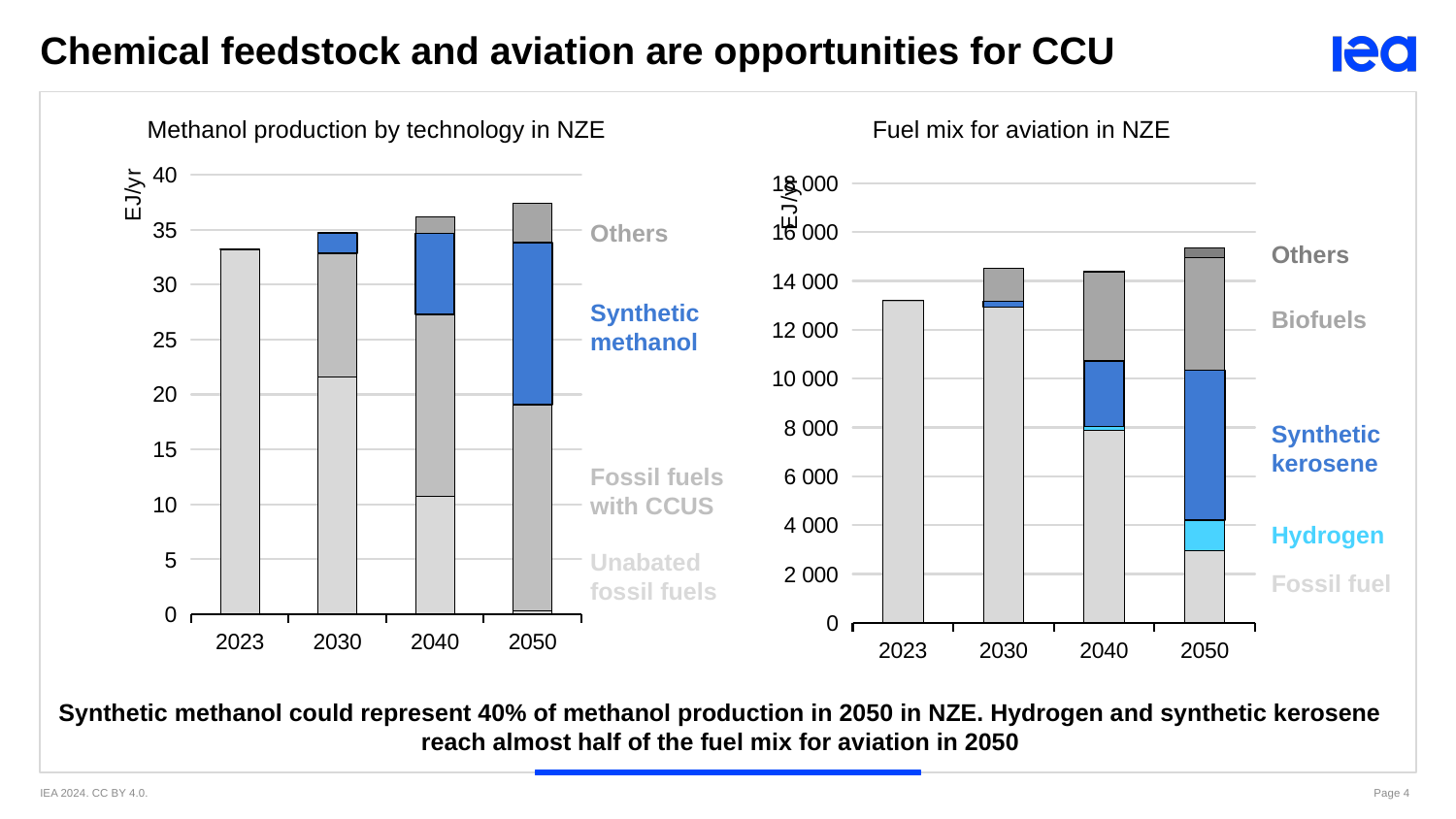
In the 'Fuel mix for aviation in NZE' chart, which year has the tallest total bar? 2050 In the 'Fuel mix for aviation in NZE' chart, is the 'Fossil fuel' value larger in 2023 or in 2050? 2023 What kind of chart is the 'Methanol production by technology in NZE' chart? Stacked bar chart In the 'Fuel mix for aviation in NZE' chart, how many series are listed in the legend? 5 In the 'Methanol production by technology in NZE' chart, does total methanol production rise or fall from 2023 to 2050? rise In the 'Methanol production by technology in NZE' chart, how many series are listed in the legend? 4 In the 'Fuel mix for aviation in NZE' chart, is the 'Fossil fuel' value for 2050 greater or less than 4 000? less In the 'Methanol production by technology in NZE' chart, which year has the tallest total bar? 2050 In the 'Fuel mix for aviation in NZE' chart, which series is shown in light blue? Hydrogen In the 'Methanol production by technology in NZE' chart, is the total for 2023 greater or less than 30 EJ/yr? greater In the 'Methanol production by technology in NZE' chart, is the 'Unabated fossil fuels' value for 2040 greater or less than 15 EJ/yr? less In the 'Methanol production by technology in NZE' chart, how many years are shown on the x axis? 4